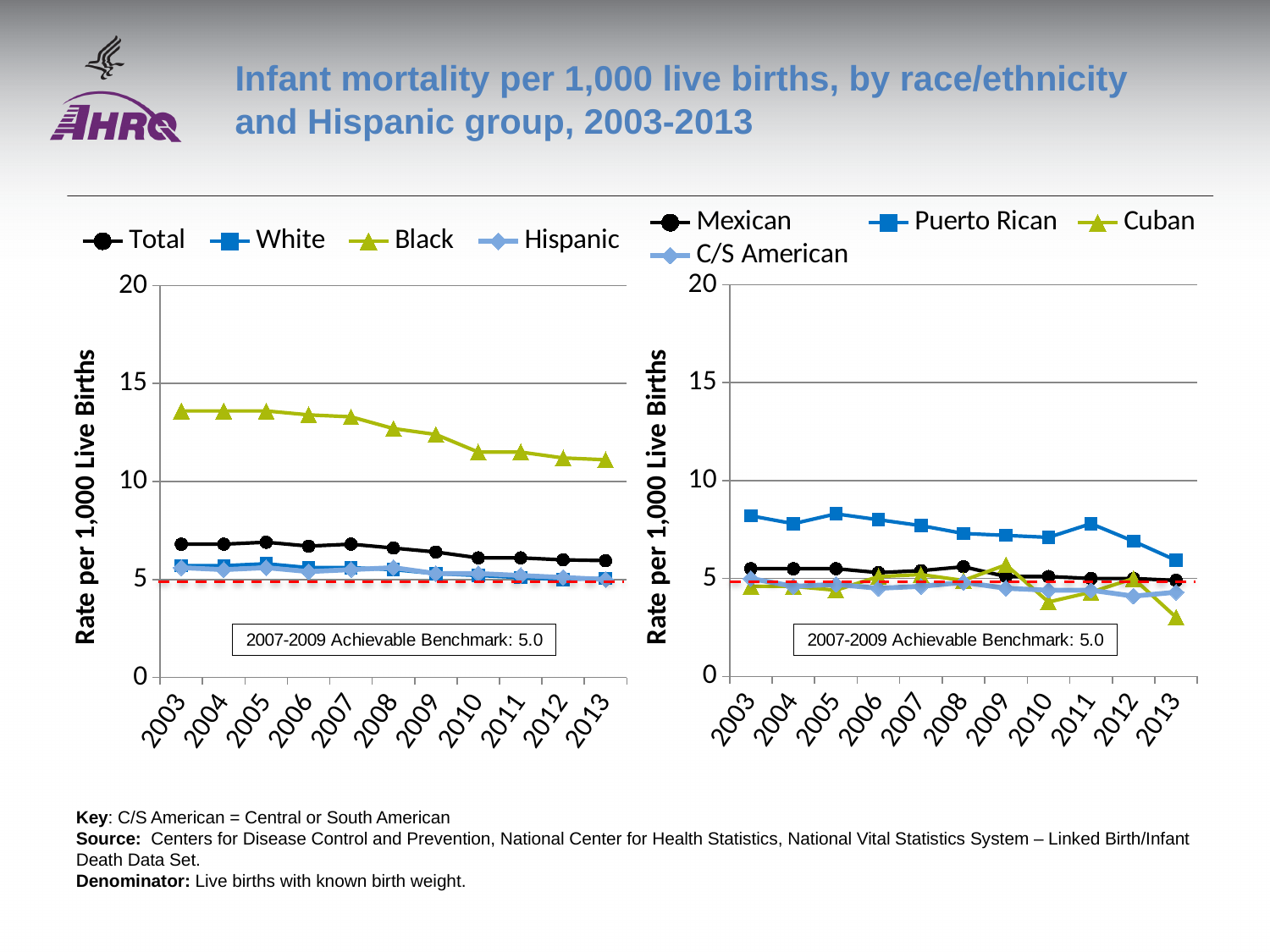
What kind of chart is the left chart on the slide? line chart How many series does the legend of the right chart list? 4 In the right chart, which series has the lowest value in 2013? Cuban In the right chart, which is larger in 2005, the value for Puerto Rican or the value for Mexican? Puerto Rican What is the 2007-2009 achievable benchmark shown on the charts? 5.0 In the left chart, does the Black series rise or fall from 2003 to 2013? fall How many series does the legend of the left chart list? 4 How many years are shown on the x axis of the left chart? 11 In the left chart, is the value for Black in 2003 greater or less than 10? greater In the left chart, is the value for White in 2013 greater or less than 10? less In the right chart, is the value for Puerto Rican in 2003 greater or less than 5? greater In the left chart, which series has the highest infant mortality rate in 2003? Black